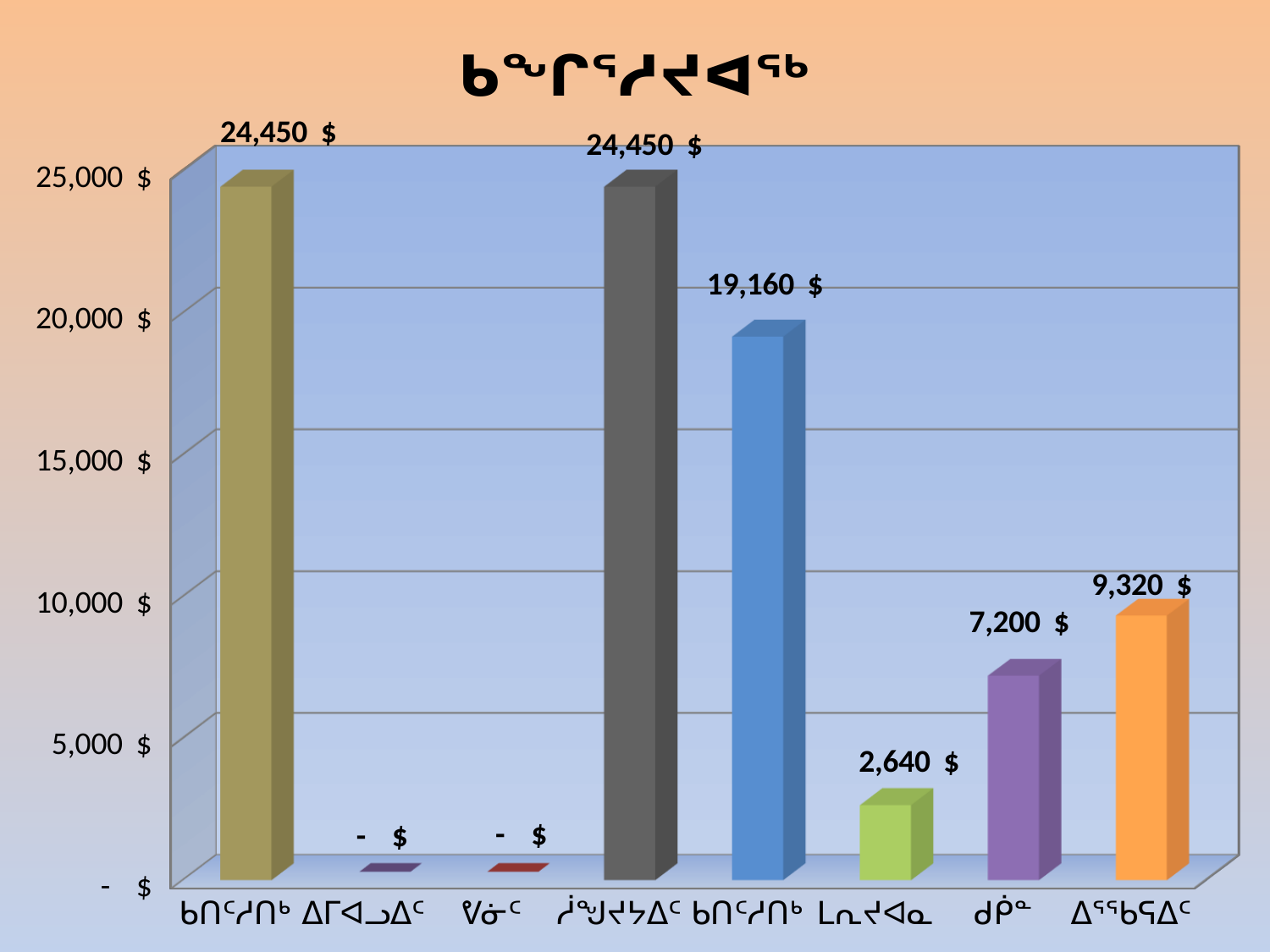
How many bars show a value of "- $" (zero)? 2 What type of chart is shown on the slide? bar chart What is the value shown for the seventh (purple) bar? 7,200 $ What is the value shown for the fifth (blue) bar? 19,160 $ What is the value shown for the sixth (green) bar? 2,640 $ Which is larger, the value of the purple bar or the value of the orange bar? the orange bar (9,320 $) What is the value shown for the last (orange) bar on the right? 9,320 $ What is the highest value labelled on the vertical axis? 25,000 $ What is the value shown for the first (leftmost, olive-coloured) bar? 24,450 $ How many bars (categories) are plotted in the chart? 8 What is the difference between the value of the blue bar (19,160 $) and the orange bar (9,320 $)? 9,840 $ What is the highest value shown in the chart? 24,450 $